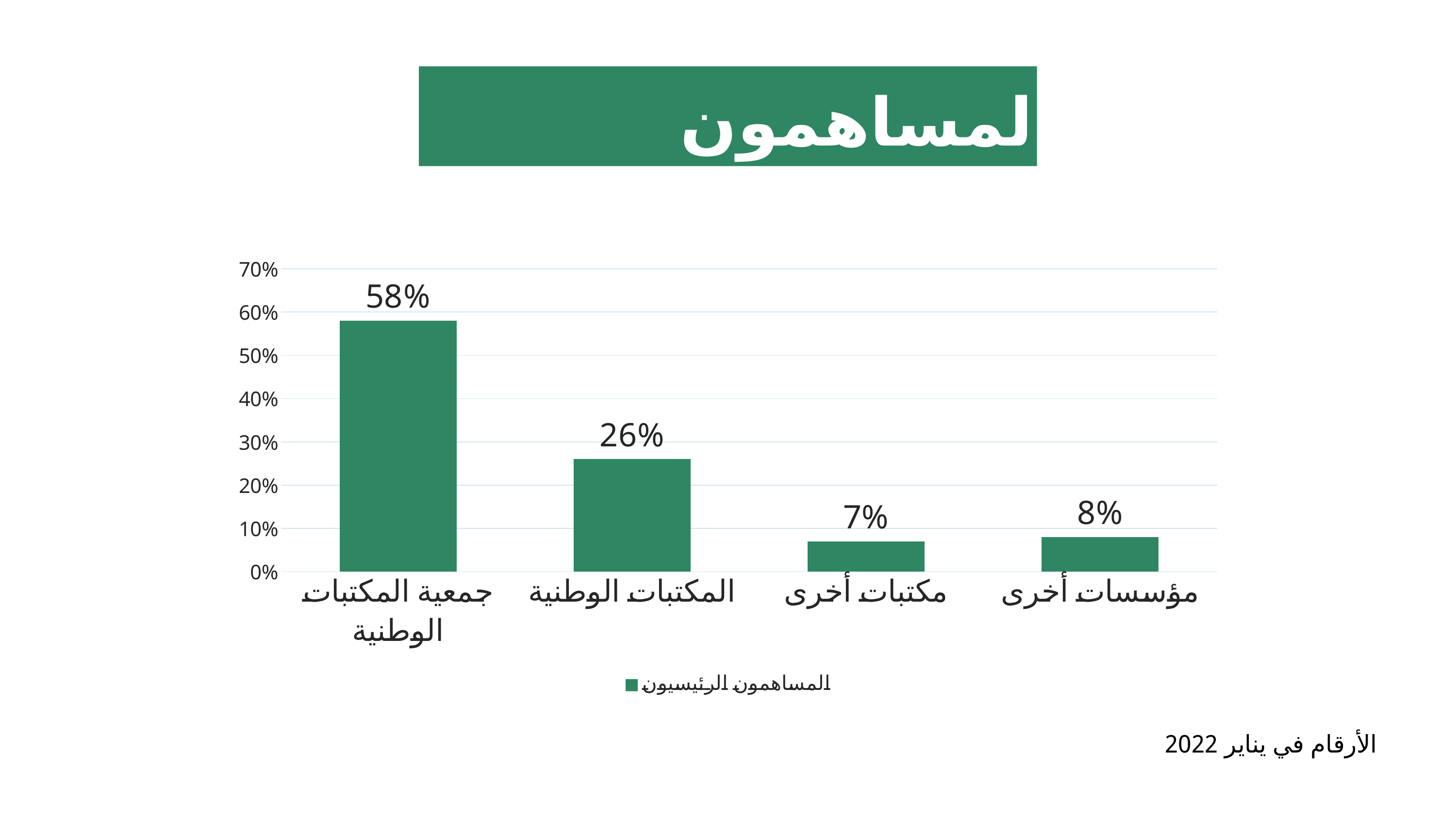
What is the value for مؤسسات أخرى? 8% What is the value for جمعية المكتبات الوطنية? 58% Is the value for المكتبات الوطنية greater or less than 30%? less What is the value for مكتبات أخرى? 7% Which category has the lowest value? مكتبات أخرى Which is larger, the value for مؤسسات أخرى or the value for مكتبات أخرى? مؤسسات أخرى What is the legend entry shown below the chart? المساهمون الرئيسيون How many categories are shown on the x axis? 4 What is the value for المكتبات الوطنية? 26% What kind of chart is shown on the slide? bar chart What is the difference between the values for جمعية المكتبات الوطنية and المكتبات الوطنية? 32% Which category has the highest value? جمعية المكتبات الوطنية